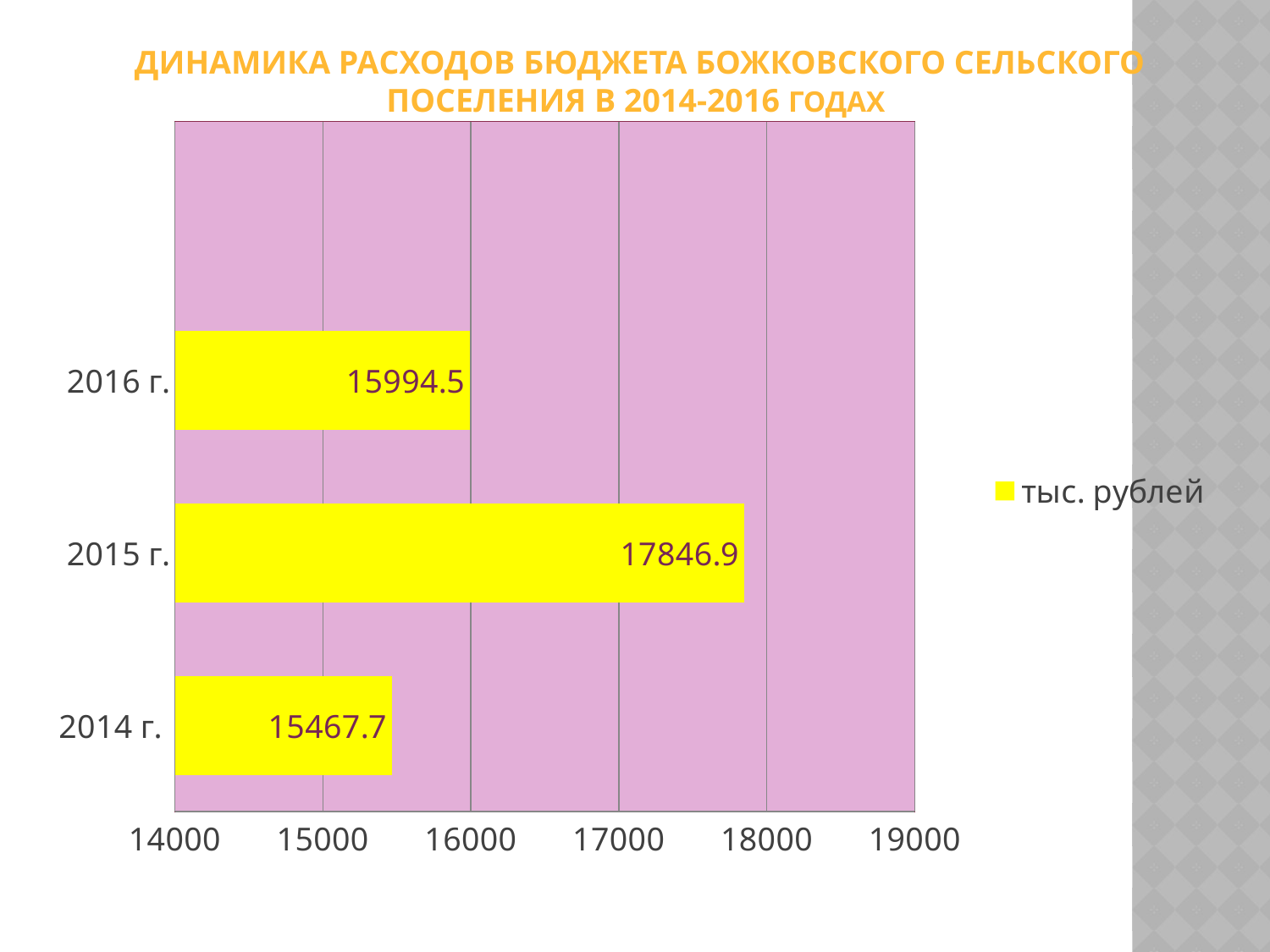
Is the value for 2015 г. greater or less than 17000? greater How many years are shown in the chart? 3 What is the difference between the values for 2015 г. and 2014 г.? 2379.2 What kind of chart is shown on the slide? bar chart What is the difference between the values for 2016 г. and 2014 г.? 526.8 What is the value for 2015 г.? 17846.9 What is the legend entry of the chart? тыс. рублей Which year has the highest value? 2015 г. Which year has the lowest value? 2014 г. What is the value for 2014 г.? 15467.7 What is the value for 2016 г.? 15994.5 Which is larger, the value for 2016 г. or the value for 2014 г.? 2016 г.